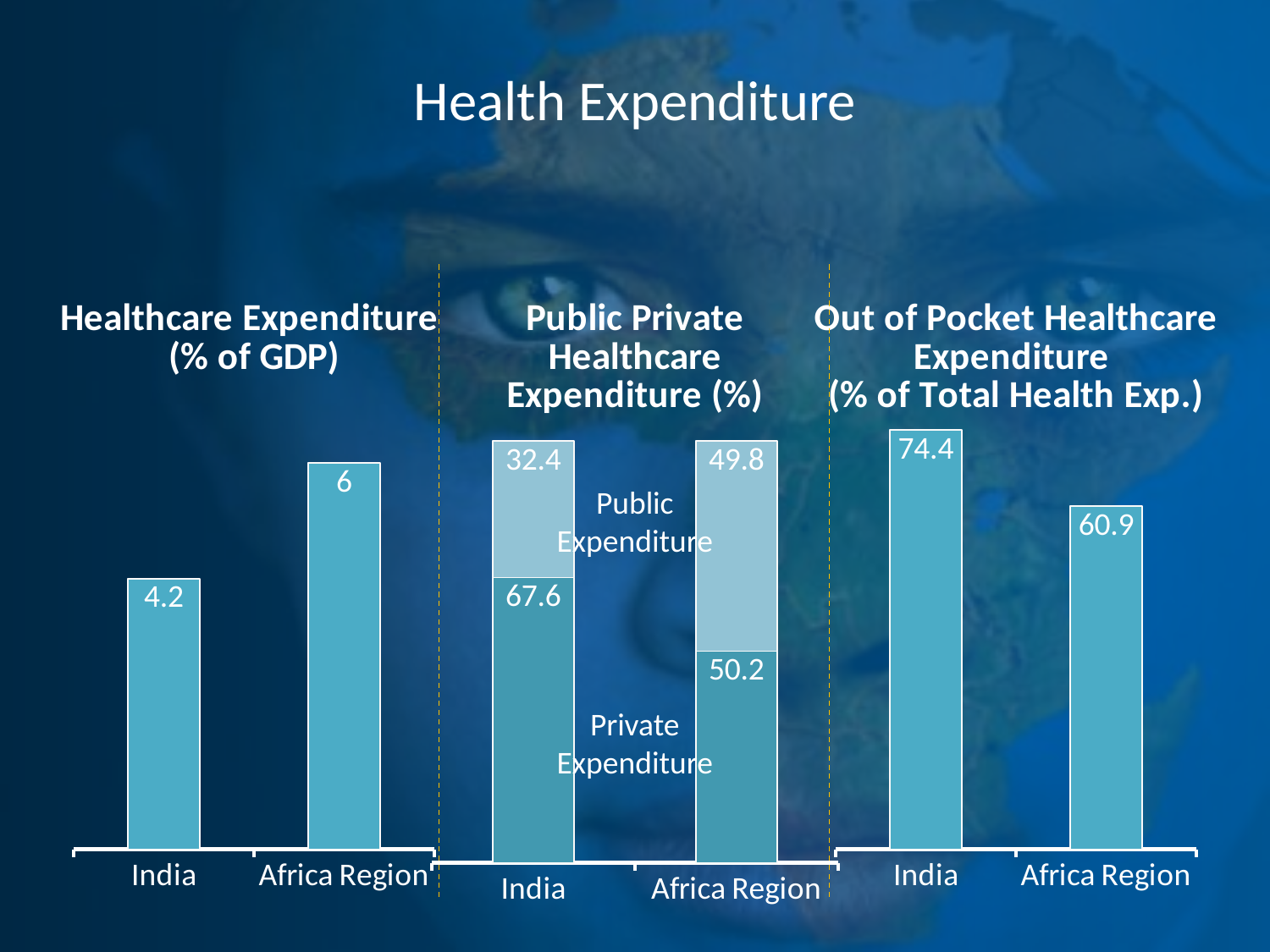
In the Public Private Healthcare Expenditure (%) chart, what is the total of the stacked bar for India? 100 In the Healthcare Expenditure (% of GDP) chart, what is the difference between the Africa Region and India values? 1.8 In the Public Private Healthcare Expenditure (%) chart, what is the Private Expenditure value for India? 67.6 In the Healthcare Expenditure (% of GDP) chart, what is the value for Africa Region? 6 In the Public Private Healthcare Expenditure (%) chart, what is the Public Expenditure value for Africa Region? 49.8 In the Out of Pocket Healthcare Expenditure chart, what is the difference between the India and Africa Region values? 13.5 In the Public Private Healthcare Expenditure (%) chart, how many series are shown? 2 In the Out of Pocket Healthcare Expenditure chart, what is the value for India? 74.4 In the Healthcare Expenditure (% of GDP) chart, what is the value for India? 4.2 In the Healthcare Expenditure (% of GDP) chart, which category has the higher value? Africa Region What type of chart is the Out of Pocket Healthcare Expenditure chart? Bar chart In the Out of Pocket Healthcare Expenditure chart, which category has the lower value? Africa Region